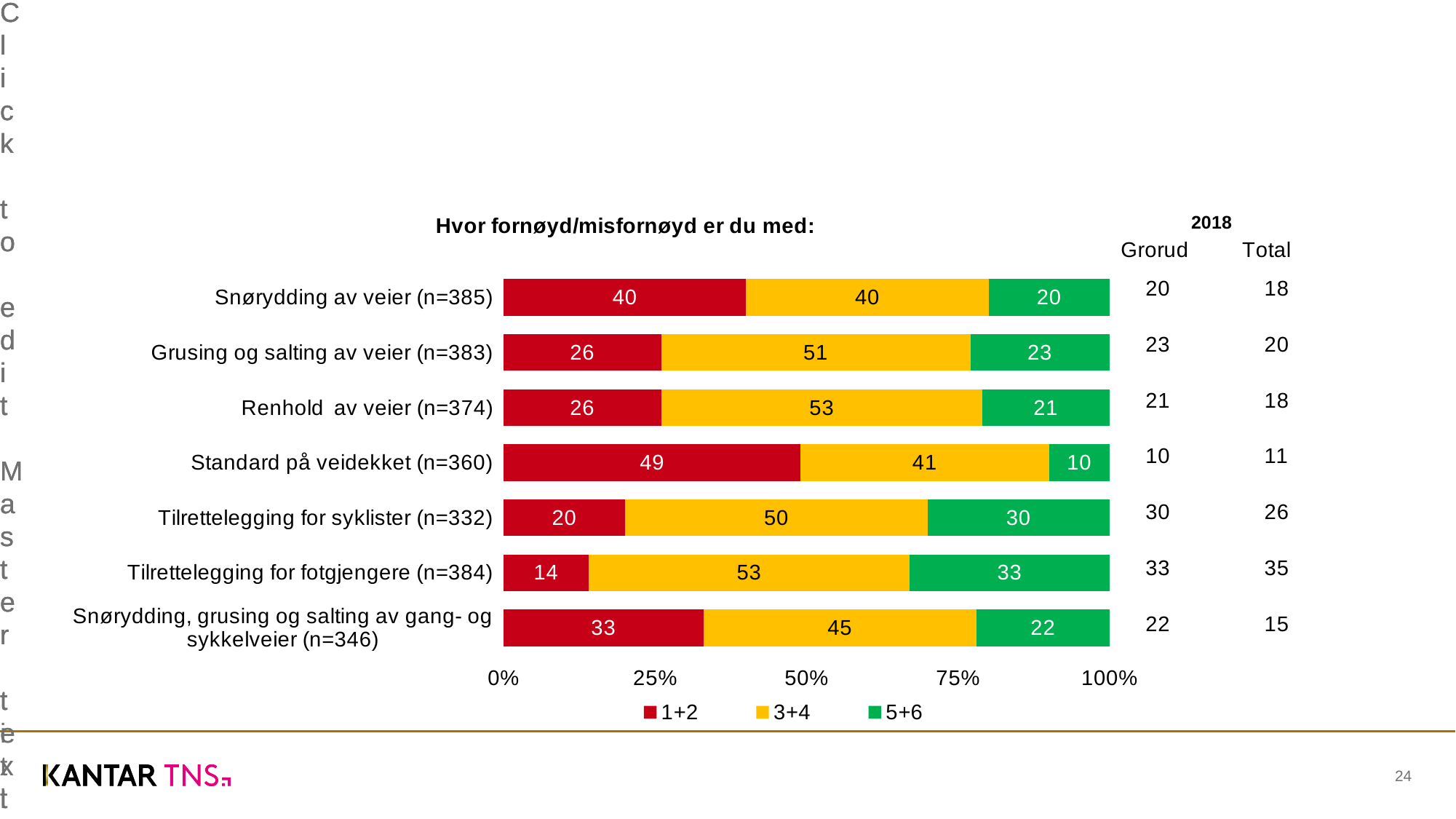
What is the value of the 3+4 series for Renhold av veier (n=374)? 53 What kind of chart is shown on the slide? Stacked bar chart What is the difference between the 5+6 values for Tilrettelegging for syklister (n=332) and Snørydding av veier (n=385)? 10 What is the total of the stacked bar for Grusing og salting av veier (n=383)? 100 What is the title of the chart? Hvor fornøyd/misfornøyd er du med: How many categories are plotted in the chart? 7 How many series does the legend list? 3 What is the value of the 5+6 series for Tilrettelegging for fotgjengere (n=384)? 33 Which category has the lowest value for the 5+6 series? Standard på veidekket (n=360) What is the value of the 1+2 series for Standard på veidekket (n=360)? 49 Which category has the highest value for the 1+2 series? Standard på veidekket (n=360) Which is larger: the 1+2 value for Snørydding av veier (n=385) or the 1+2 value for Snørydding, grusing og salting av gang- og sykkelveier (n=346)? Snørydding av veier (n=385)